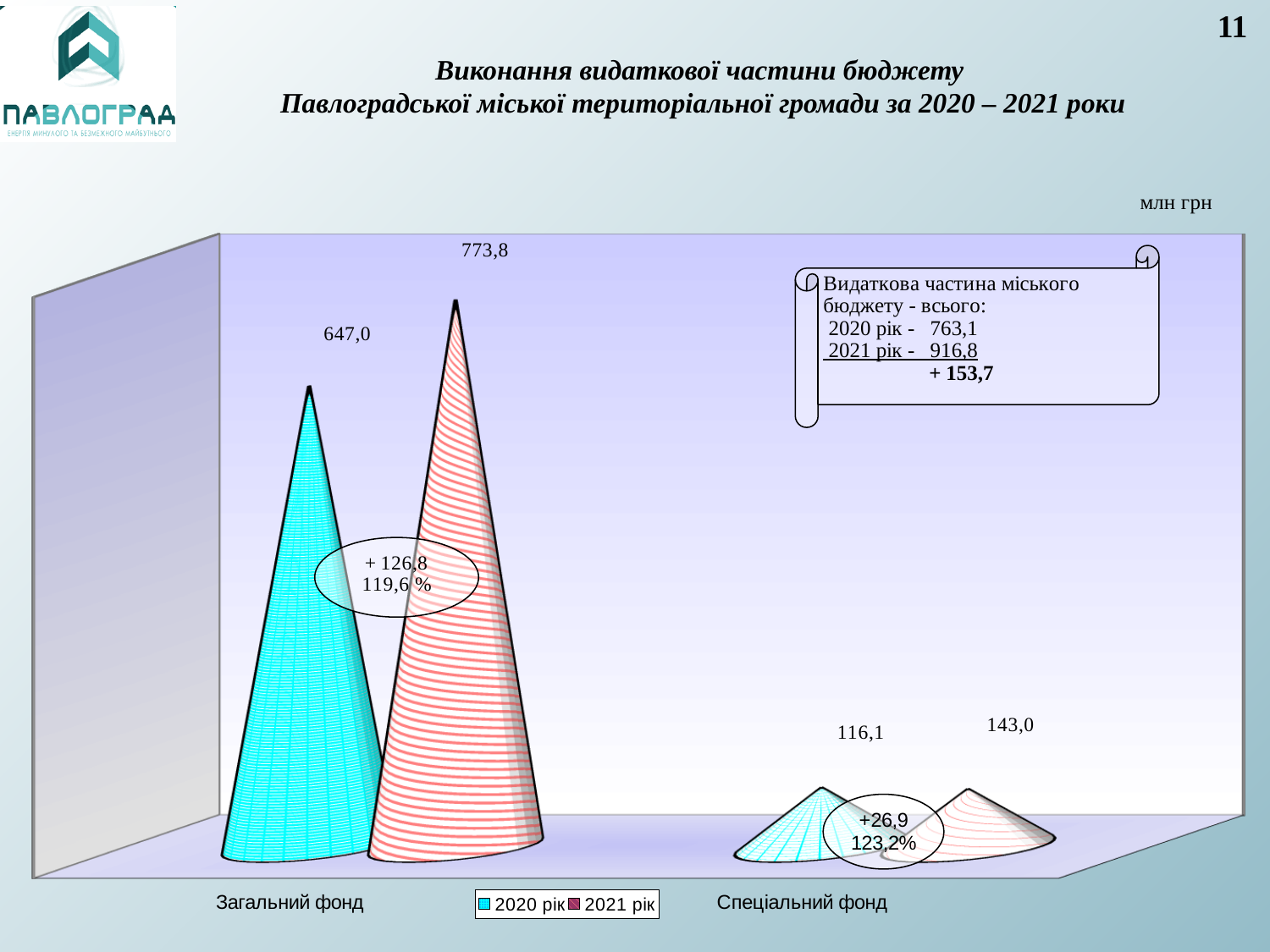
How many series does the legend list? 2 What is the value for Загальний фонд in 2021 рік? 773,8 What unit is stated for the values on the chart? млн грн What is the value for Спеціальний фонд in 2021 рік? 143,0 What is the value for Загальний фонд in 2020 рік? 647,0 Which is larger for Спеціальний фонд: the 2020 рік value or the 2021 рік value? 2021 рік Which category has the highest value in 2021 рік? Загальний фонд What is the difference between the 2021 рік and 2020 рік values for Спеціальний фонд? 26,9 What is the difference between the 2021 рік and 2020 рік values for Загальний фонд? 126,8 What is the value for Спеціальний фонд in 2020 рік? 116,1 Which category has the lowest value in 2020 рік? Спеціальний фонд How many categories are shown on the x axis? 2